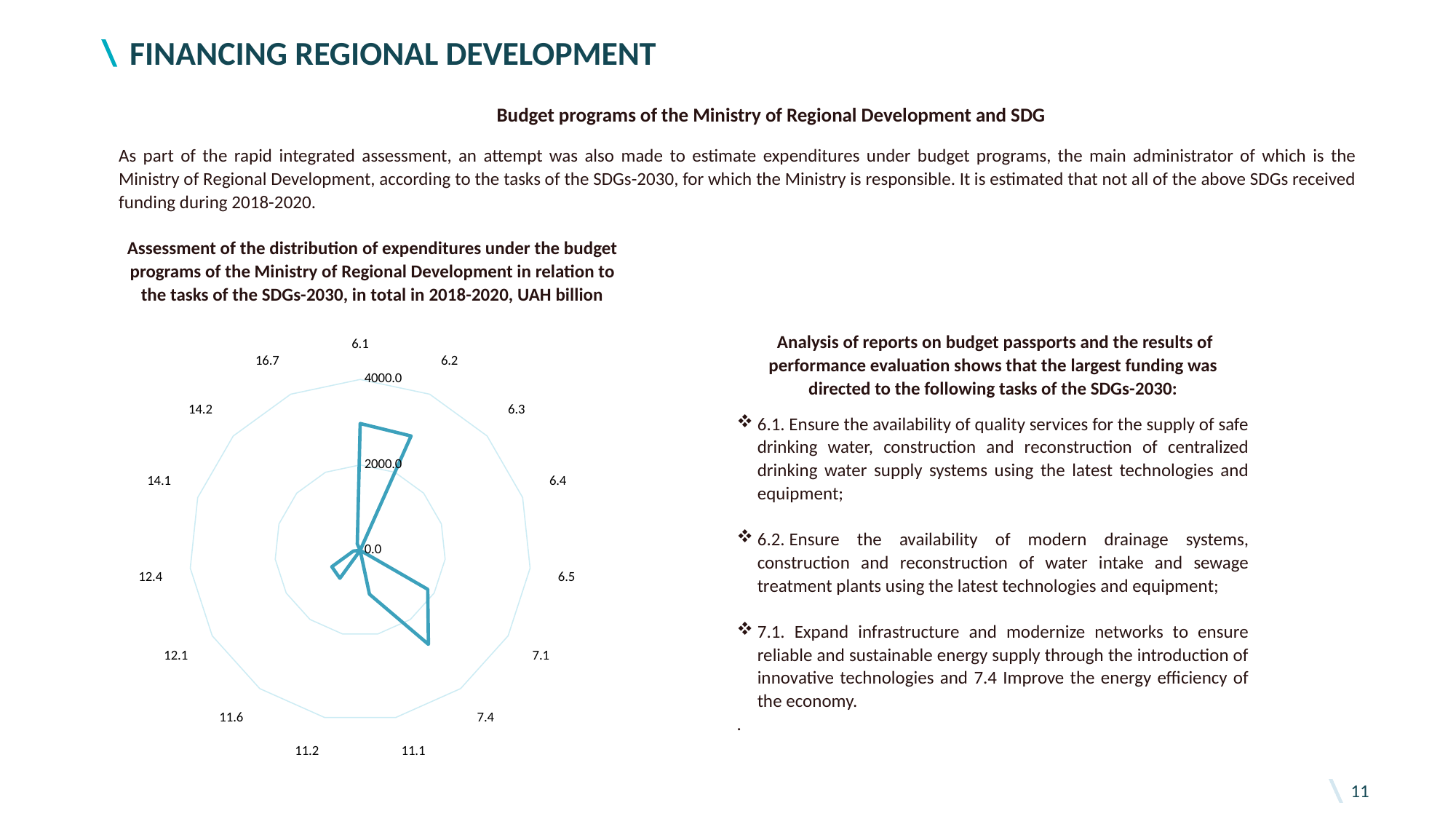
Which has the larger value, task 7.1 or task 12.4? 7.1 In what unit are the expenditures in the chart expressed, according to its title? UAH billion What kind of chart is shown on the slide? Radar chart Is the value for task 6.2 greater or less than 2000.0? greater Is the value for task 12.4 greater or less than 2000.0? less What is the highest axis tick value shown on the radar chart? 4000.0 Is the value for task 6.1 greater or less than 2000.0? greater How many SDG task categories are plotted around the radar chart? 15 Which has the larger value, task 6.1 or task 7.4? 6.1